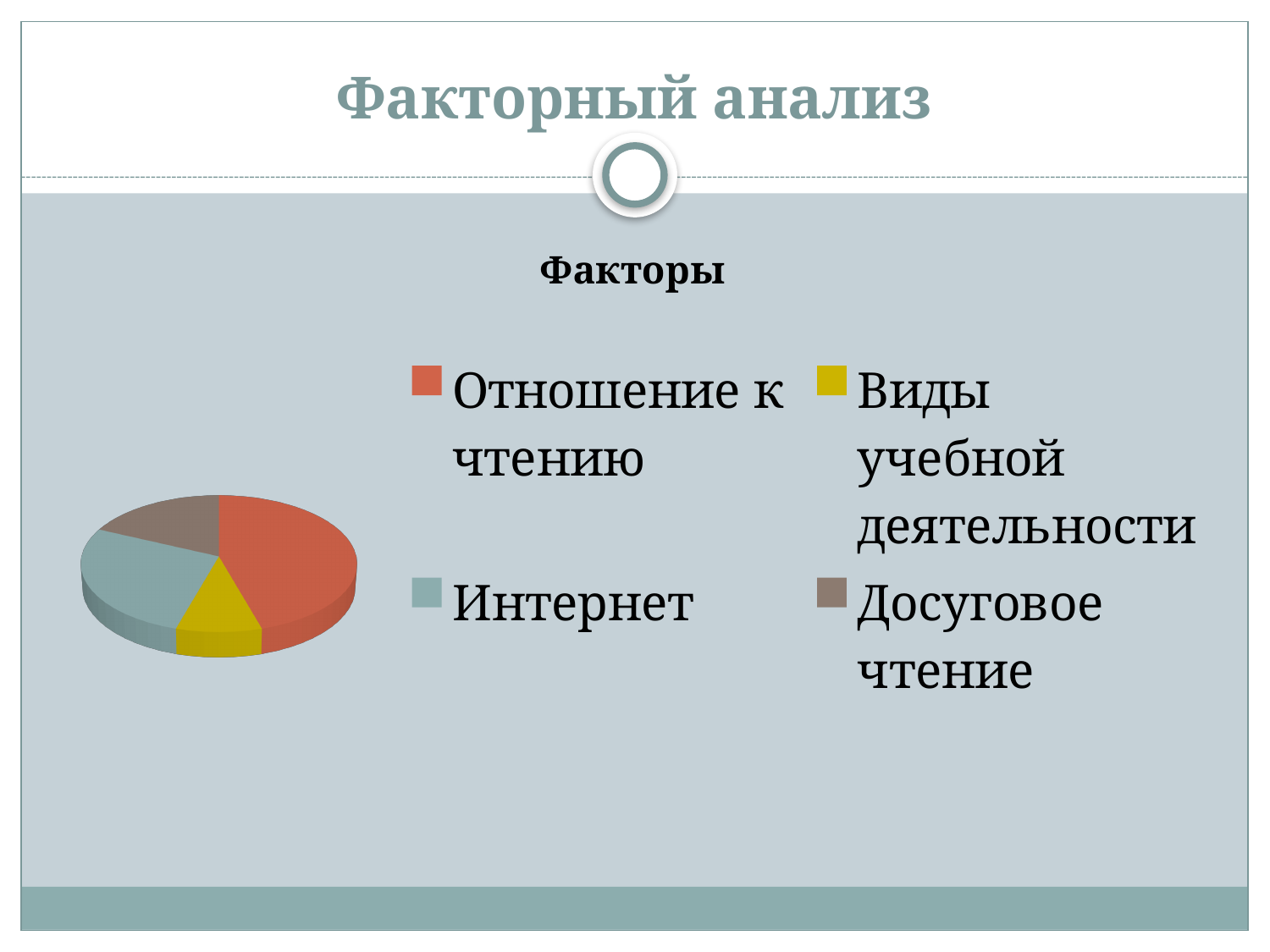
What is the title of the chart? Факторы How many slices does the pie chart have? 4 Which category has the largest slice of the pie? Отношение к чтению Which slice is larger, Интернет or Виды учебной деятельности? Интернет Which slice is larger, Отношение к чтению or Досуговое чтение? Отношение к чтению What kind of chart is shown on the slide? pie chart Which slice is larger, Интернет or Досуговое чтение? Интернет How many entries does the chart legend list? 4 Which colour represents Интернет in the pie chart? teal (grey-blue)